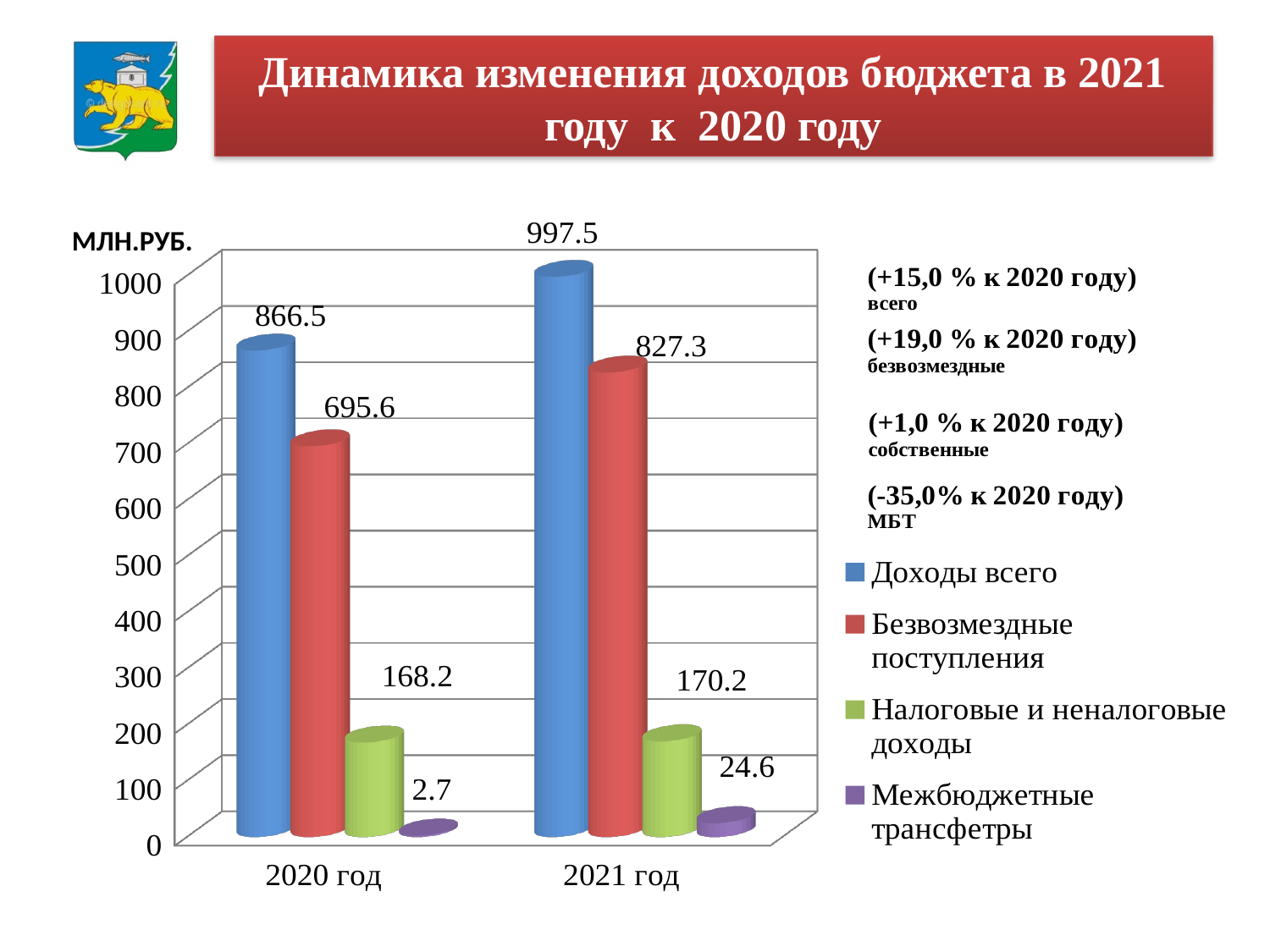
Which is larger: Налоговые и неналоговые доходы in 2020 год or Межбюджетные трансфетры in 2021 год? Налоговые и неналоговые доходы in 2020 год Which series has the lowest value for 2020 год? Межбюджетные трансфетры What is the difference between Доходы всего in 2021 год and in 2020 год? 131.0 What is the value of Налоговые и неналоговые доходы for 2020 год? 168.2 How many categories are shown on the x axis? 2 What is the value of Межбюджетные трансфетры for 2021 год? 24.6 What kind of chart is shown on the slide? Bar chart What is the value of Доходы всего for 2021 год? 997.5 What is the value of Безвозмездные поступления for 2020 год? 695.6 What is the difference between Безвозмездные поступления in 2021 год and in 2020 год? 131.7 Which series has the highest value for 2021 год? Доходы всего How many series does the legend list? 4